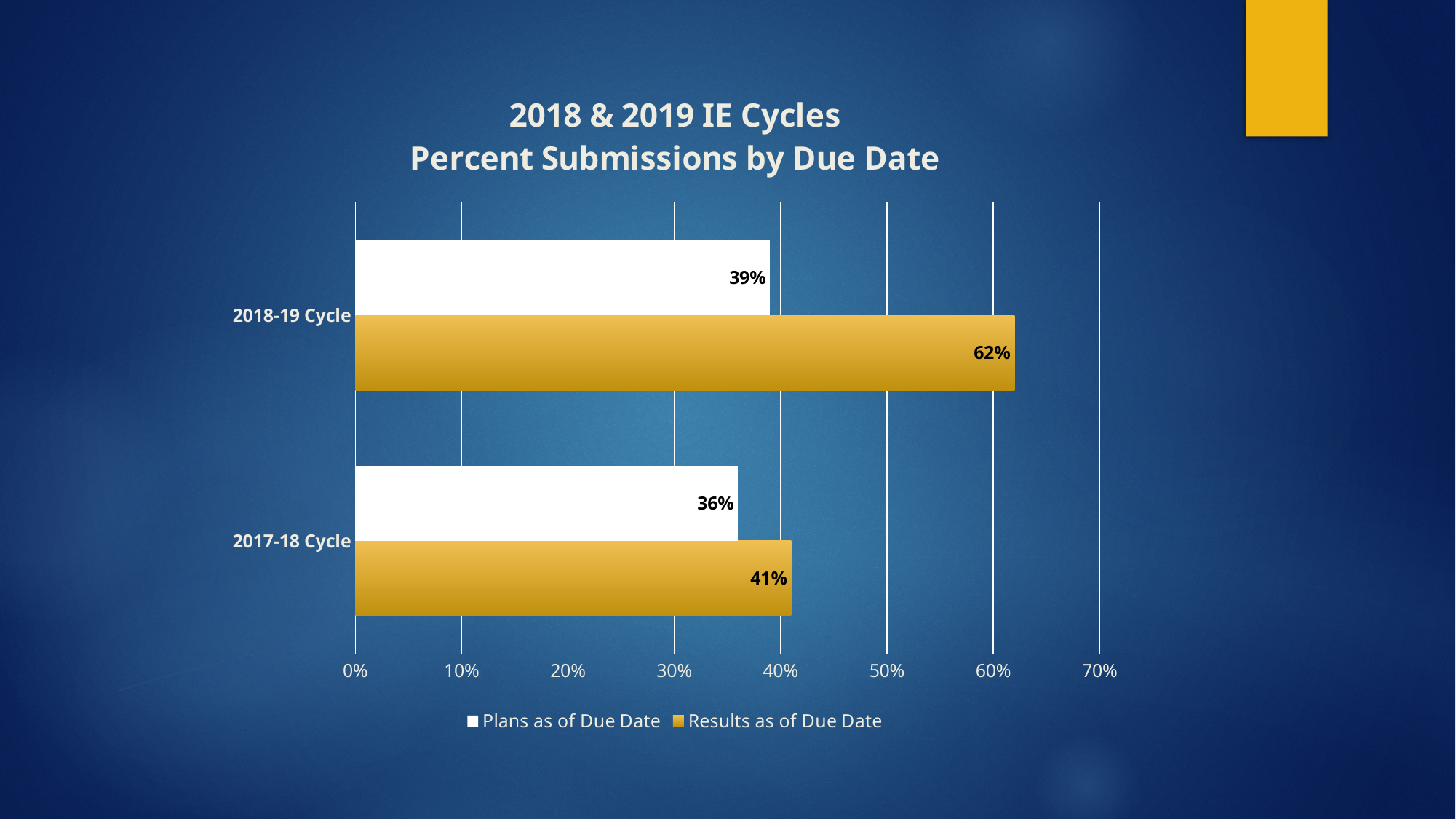
What kind of chart is shown on the slide? Bar chart Which is larger in the 2017-18 Cycle: Plans as of Due Date or Results as of Due Date? Results as of Due Date What is the value for Results as of Due Date in the 2017-18 Cycle? 41% How many cycles are shown on the chart? 2 What is the value for Plans as of Due Date in the 2018-19 Cycle? 39% How many series does the legend list? 2 What is the value for Plans as of Due Date in the 2017-18 Cycle? 36% What is the difference in Results as of Due Date between the 2018-19 Cycle and the 2017-18 Cycle? 21% Which cycle has the lowest value for Plans as of Due Date? 2017-18 Cycle What is the difference between Results as of Due Date and Plans as of Due Date in the 2018-19 Cycle? 23% What is the value for Results as of Due Date in the 2018-19 Cycle? 62% Which cycle has the highest value for Results as of Due Date? 2018-19 Cycle